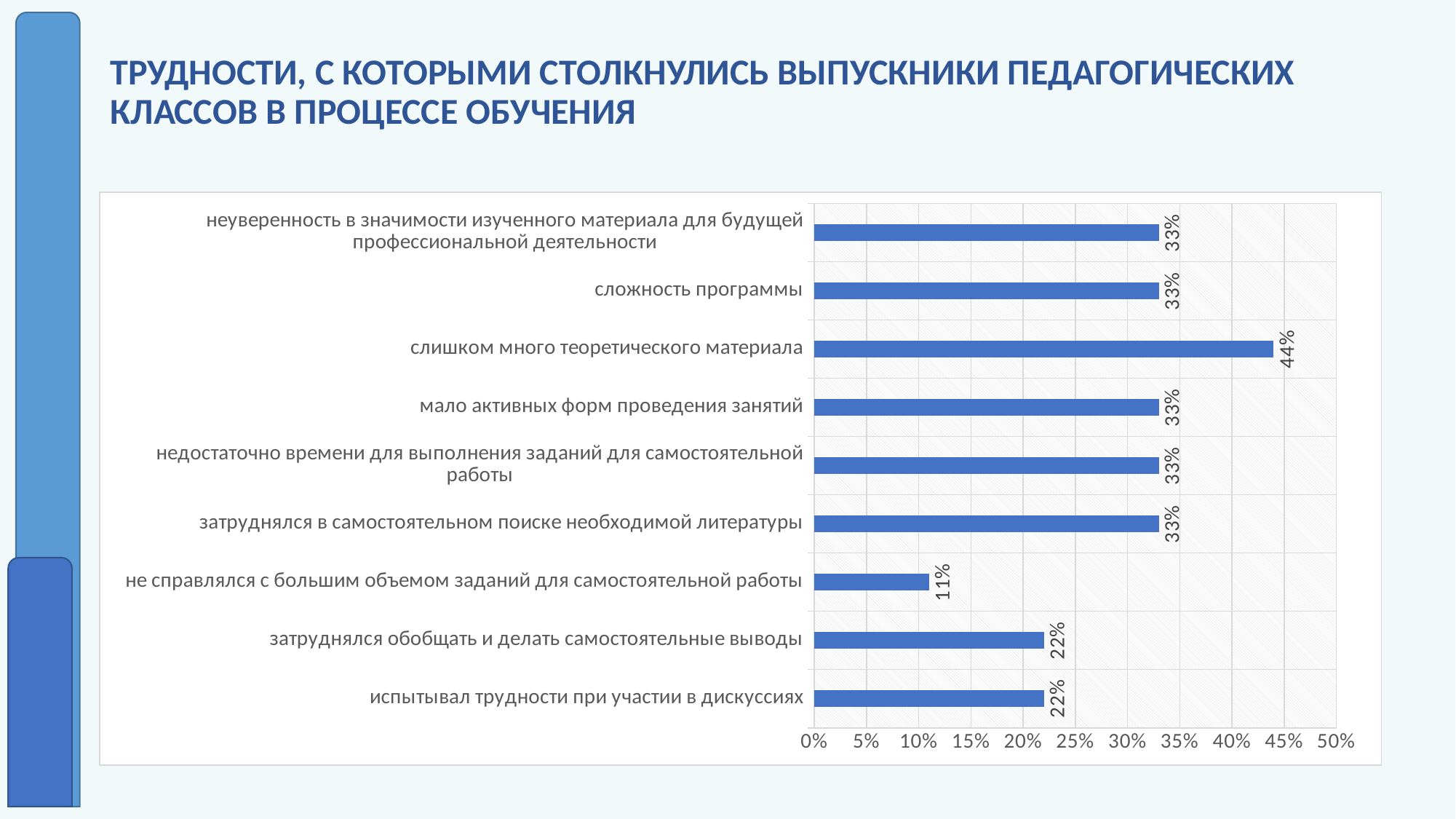
Which category has the lowest value? не справлялся с большим объемом заданий для самостоятельной работы Which category has the highest value? слишком много теоретического материала What is the value for "сложность программы"? 33% What is the value for "не справлялся с большим объемом заданий для самостоятельной работы"? 11% Is the value for "слишком много теоретического материала" greater or less than 40%? greater What kind of chart is shown on the slide? bar chart Which is larger: the value for "сложность программы" or the value for "затруднялся обобщать и делать самостоятельные выводы"? сложность программы What is the value for "испытывал трудности при участии в дискуссиях"? 22% What is the value for "слишком много теоретического материала"? 44% What is the maximum value shown on the horizontal axis of the chart? 50% What is the difference between the value for "слишком много теоретического материала" and the value for "не справлялся с большим объемом заданий для самостоятельной работы"? 33 percentage points How many categories (difficulties) are plotted in the chart? 9